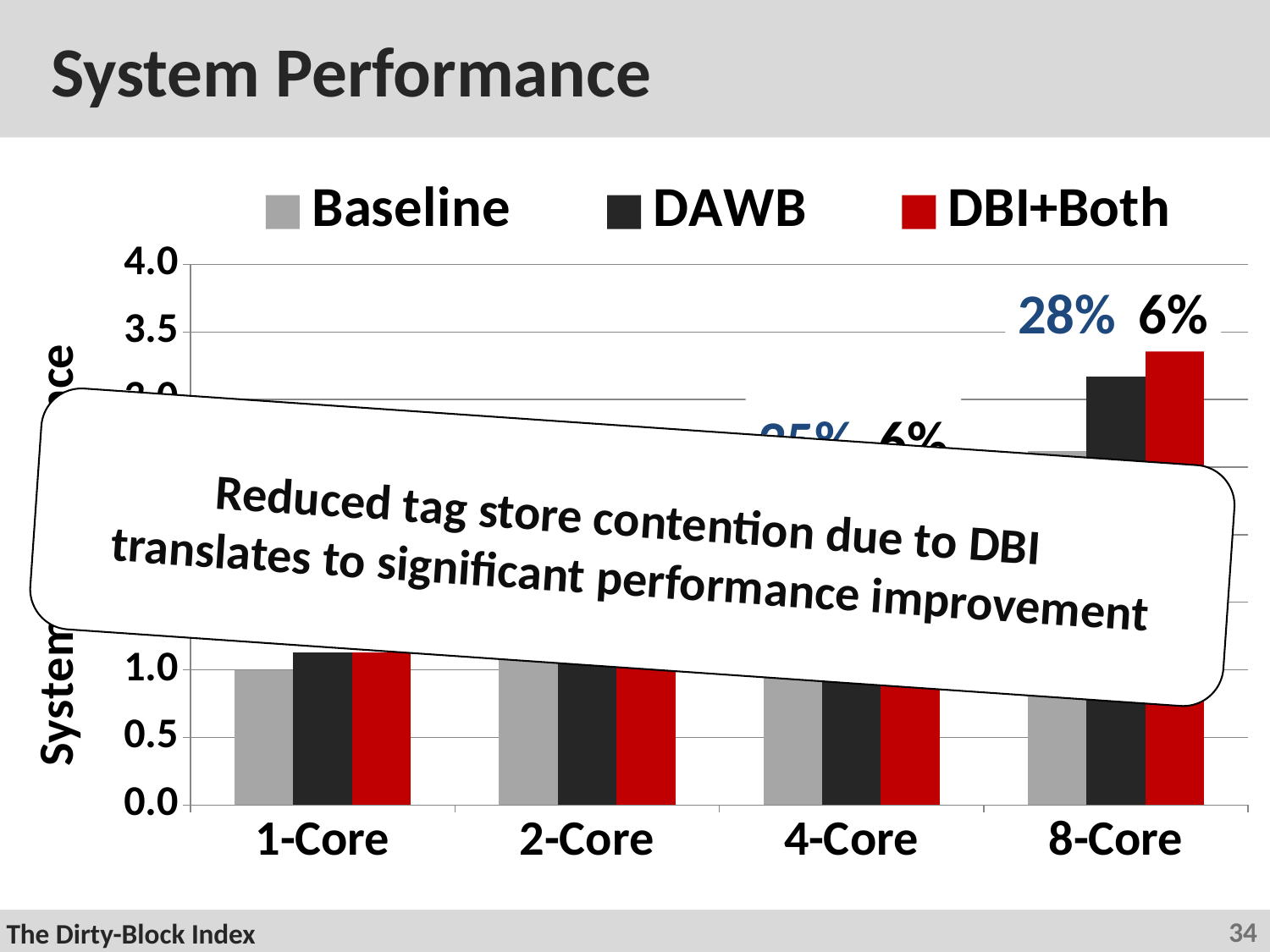
Is the DAWB value for 8-Core greater or less than 3.5? less Is the DAWB value for 1-Core greater or less than 1.0? greater For 8-Core, which is larger: the DAWB bar or the DBI+Both bar? DBI+Both What kind of chart is shown on the slide? bar chart What is the Baseline value for 1-Core? 1.0 Is the DBI+Both value for 8-Core greater or less than 3.0? greater How many series does the legend list? 3 What is the title of the slide containing the chart? System Performance What are the three series named in the legend? Baseline, DAWB, DBI+Both How many core-count categories are shown on the x axis? 4 Which core-count category has the highest DBI+Both value? 8-Core